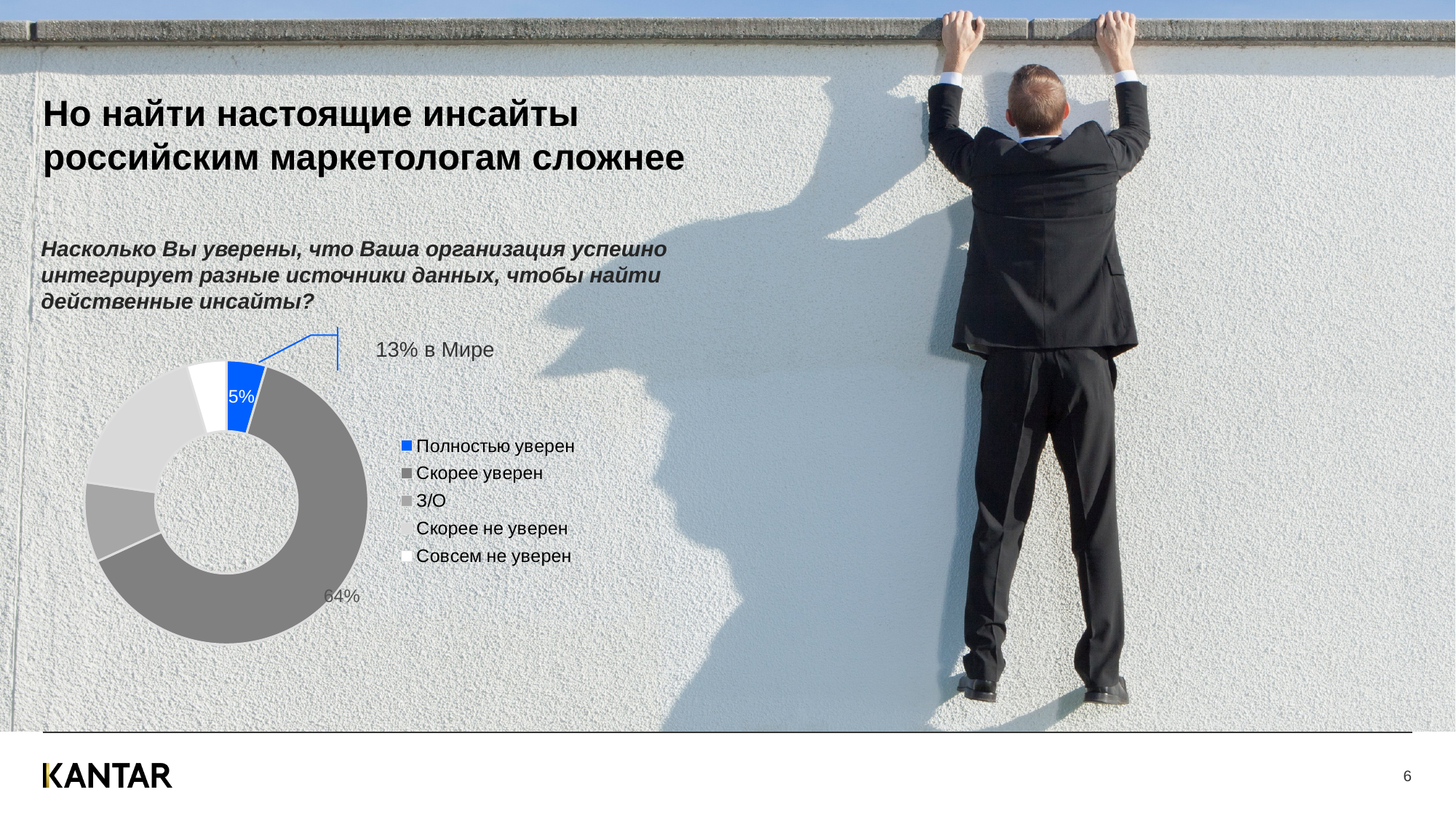
How many answer categories does the legend of the donut chart list? 5 Which slice is larger: "Скорее уверен" or "Полностью уверен"? Скорее уверен Which answer category has the largest slice in the donut chart? Скорее уверен Which slice is larger: "Скорее не уверен" or "З/О"? Скорее не уверен What share of respondents answered "Полностью уверен" in the donut chart? 5% What colour represents the "Полностью уверен" category in the donut chart? Blue What is the difference in percentage points between the "Скорее уверен" and "Полностью уверен" slices? 59 percentage points According to the annotation next to the chart, what is the share of "Полностью уверен" worldwide (в Мире)? 13% What type of chart is shown on the slide? Donut (pie) chart What share of respondents answered "Скорее уверен" in the donut chart? 64%